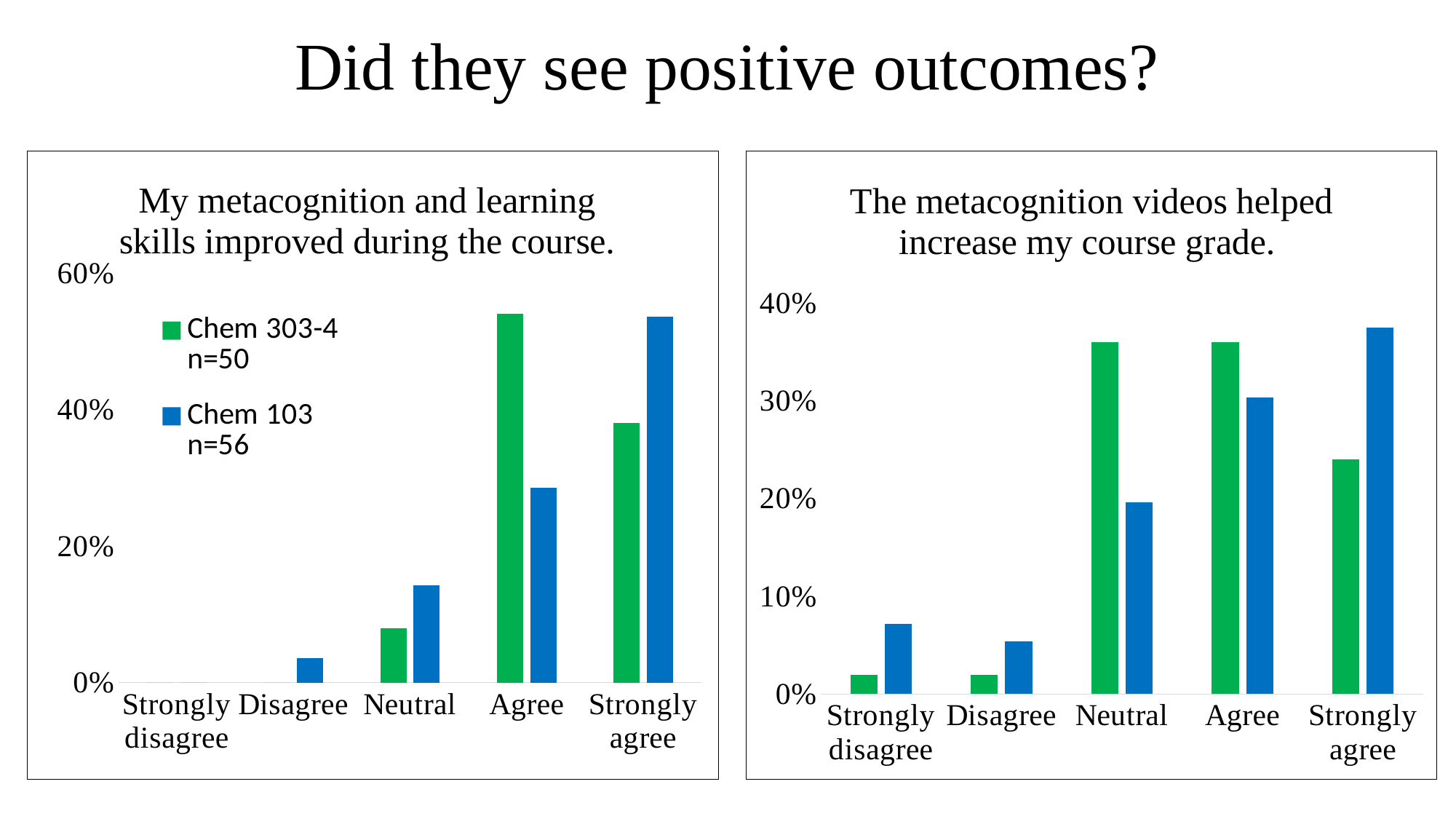
In the left chart, what colour represents the Chem 103 series? blue In the right chart ("The metacognition videos helped increase my course grade."), which series has the larger value at Strongly agree, Chem 303-4 or Chem 103? Chem 103 In the left chart ("My metacognition and learning skills improved during the course."), is the value for Chem 103 at Agree greater or less than 40%? less In the left chart ("My metacognition and learning skills improved during the course."), which category has the highest value for Chem 103? Strongly agree In the right chart ("The metacognition videos helped increase my course grade."), is the value for Chem 103 at Neutral greater or less than 30%? less In the right chart ("The metacognition videos helped increase my course grade."), is the value for Chem 303-4 at Neutral greater or less than 30%? greater In the left chart ("My metacognition and learning skills improved during the course."), which category has the highest value for Chem 303-4? Agree How many series does the legend of the left chart ("My metacognition and learning skills improved during the course.") list? 2 In the left chart ("My metacognition and learning skills improved during the course."), which series has the larger value at Neutral, Chem 303-4 or Chem 103? Chem 103 What kind of chart is the right chart ("The metacognition videos helped increase my course grade.")? bar chart How many categories are shown on the x axis of the left chart ("My metacognition and learning skills improved during the course.")? 5